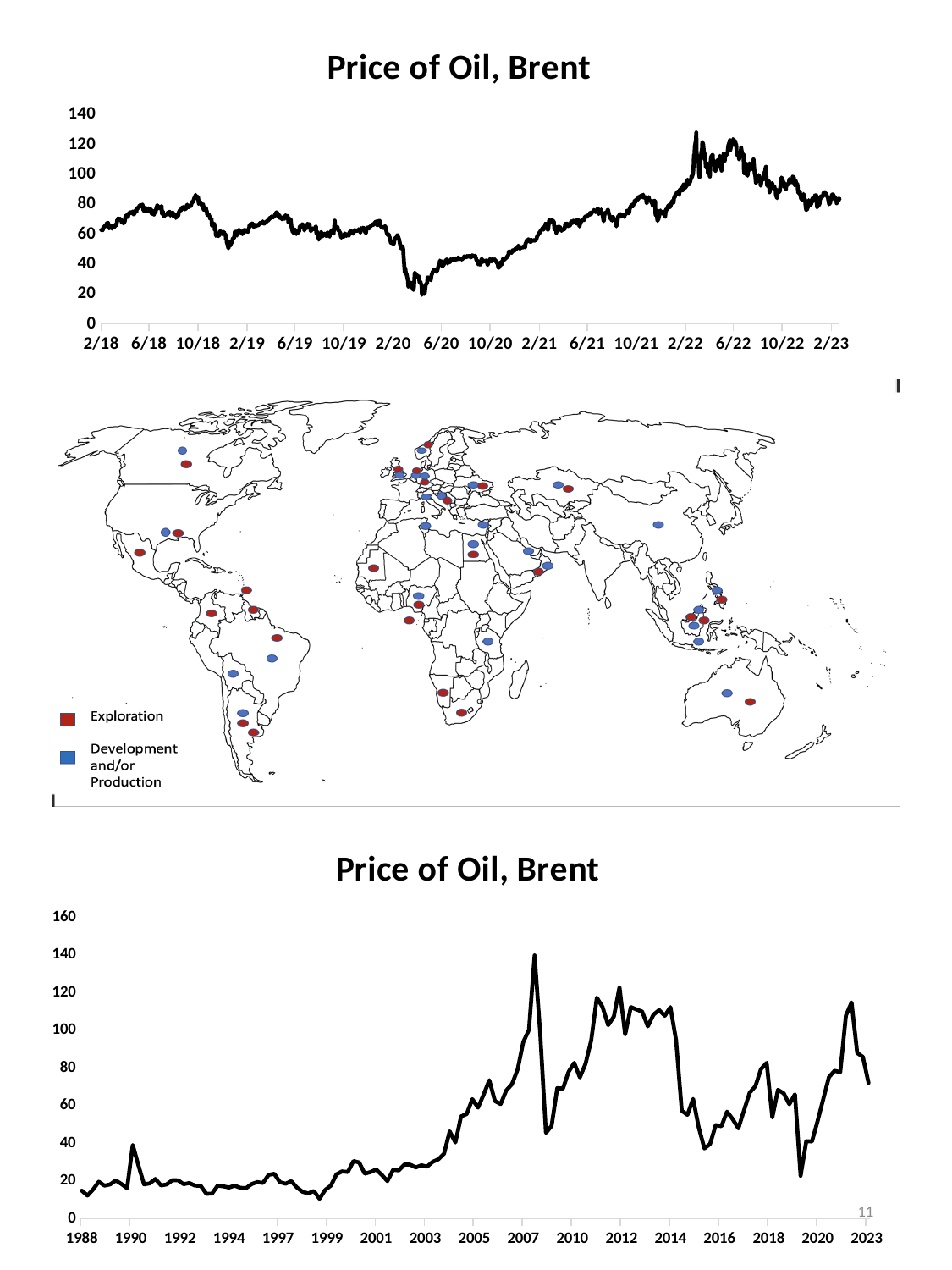
In the top chart (2/18 to 2/23), is the lowest value reached in 2020 greater or less than 40? less What kind of chart is the top chart titled 'Price of Oil, Brent'? line chart In the bottom chart (1988 to 2023), does the price generally rise or fall between 1999 and 2007? rise In the bottom chart (1988 to 2023), is the value at 1988 greater or less than 20? less In the top chart (2/18 to 2/23), does the price generally rise or fall between 6/20 and 6/22? rise In the top chart (2/18 to 2/23), is the value at 2/18 greater or less than 40? greater What is the title of the top chart? Price of Oil, Brent What kind of chart is the bottom chart titled 'Price of Oil, Brent'? line chart What two categories does the legend of the world map list? Exploration; Development and/or Production